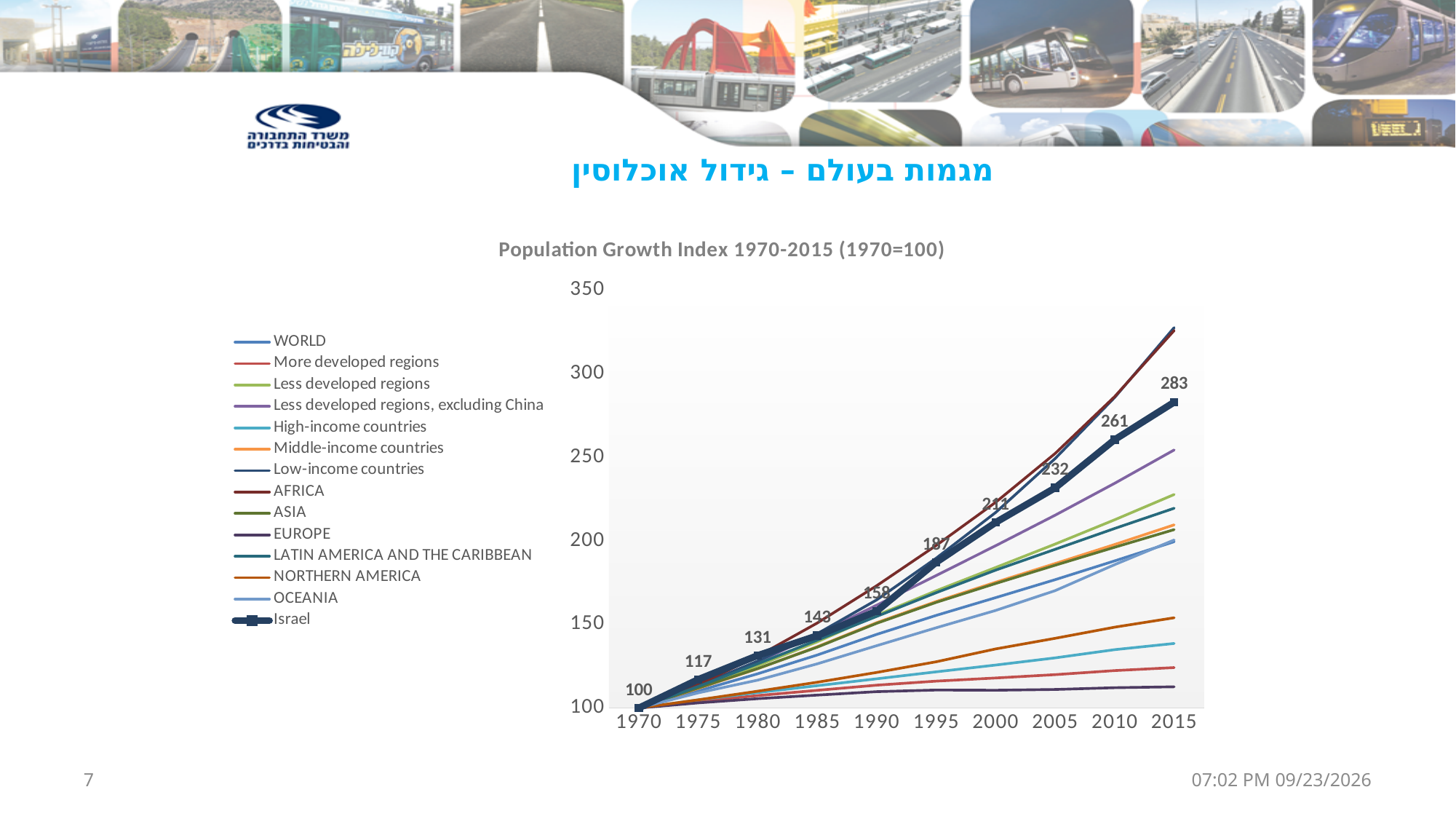
Is the value for AFRICA in 2015 greater or less than 300? greater Is the value for EUROPE in 2015 greater or less than 150? less What is the value for Israel in 1975? 117 What is the value for Israel in 2005? 232 By how much did the Israel index increase between 2010 and 2015? 22 What is the value for Israel in 2010? 261 What is the value for Israel in 2015? 283 What is the title of the chart? Population Growth Index 1970-2015 (1970=100) Does the Israel series rise or fall from 1970 to 2015? rise How many years are shown along the x axis? 10 What kind of chart is shown on the slide? line chart How many series does the chart legend list? 14